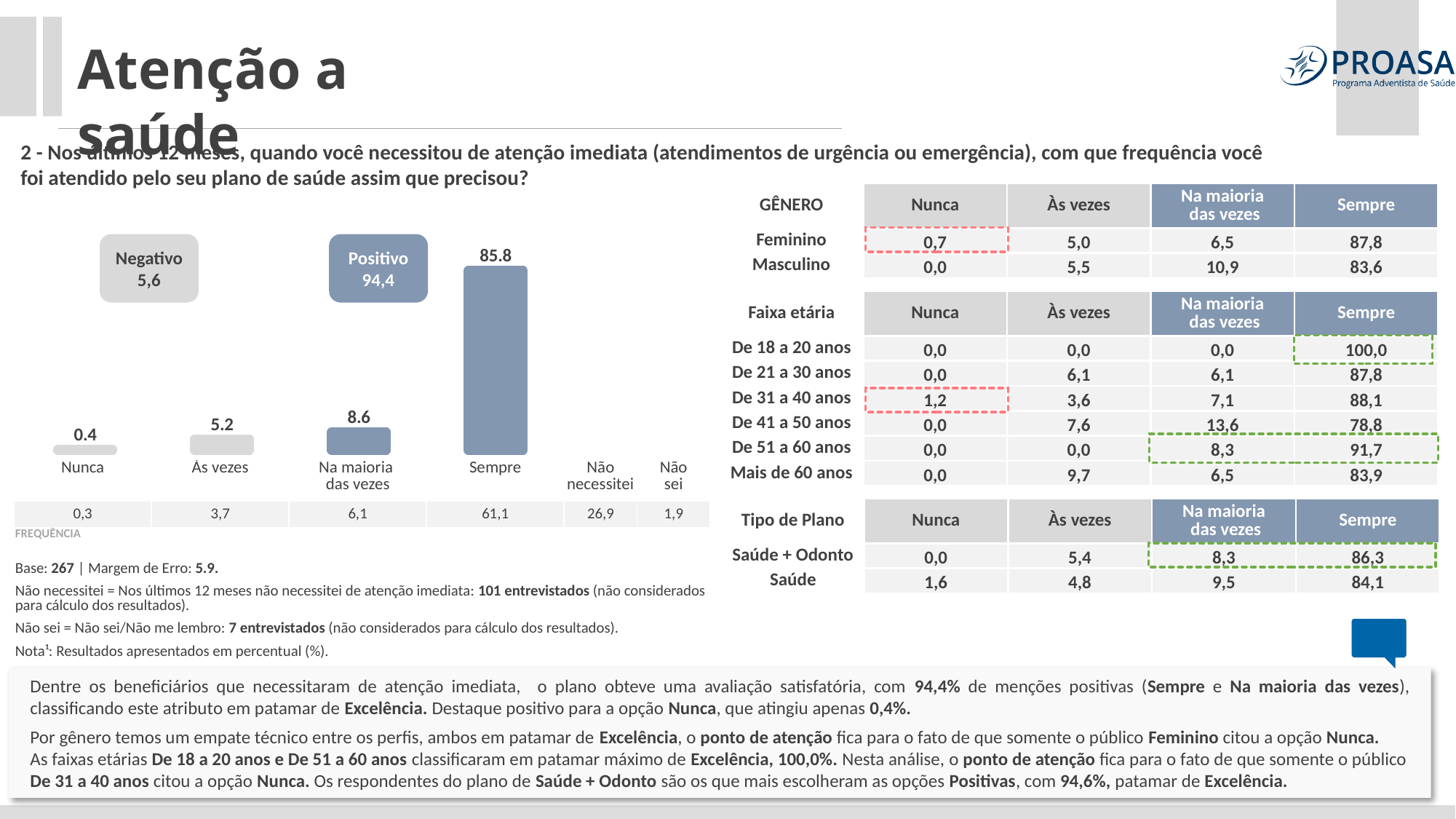
What value does the bar chart show for Às vezes? 5.2 What value does the bar chart show for Na maioria das vezes? 8.6 Do the bar values rise or fall from Nunca to Sempre along the x axis? rise Which category has the highest bar in the bar chart? Sempre Which is larger in the bar chart, Às vezes or Na maioria das vezes? Na maioria das vezes What is the difference between the values for Sempre and Na maioria das vezes in the bar chart? 77.2 What value is shown in the Negativo box above the bar chart? 5,6 What kind of chart is shown on the slide? bar chart What is the combined value of the Positivo group (Na maioria das vezes plus Sempre) shown in the bar chart? 94,4 What value does the bar chart show for Nunca? 0.4 Which category has the lowest bar in the bar chart? Nunca What value does the bar chart show for Sempre? 85.8